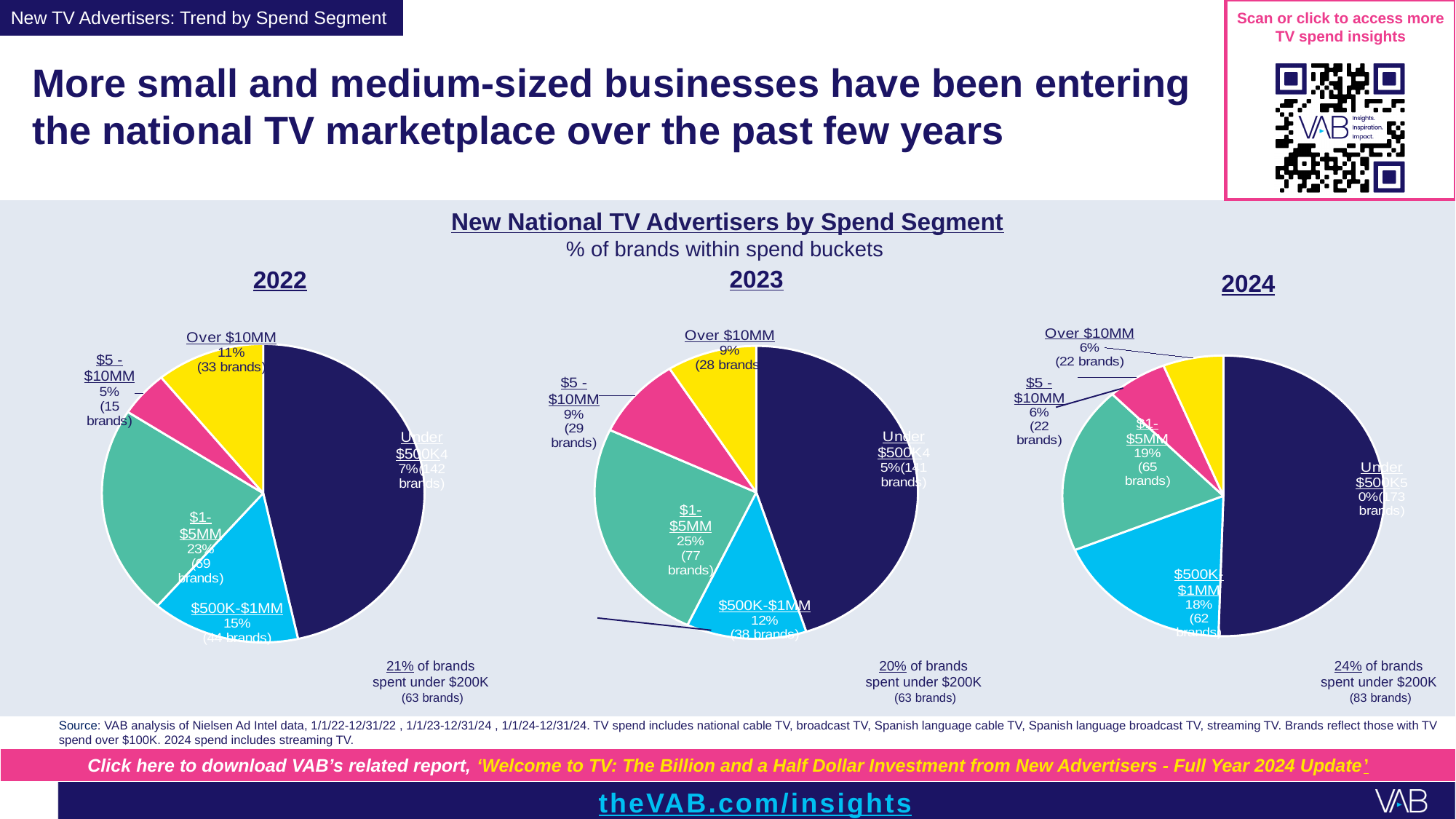
What kind of charts are shown on the slide? Pie charts How many pie charts are shown on the slide? 3 In the 2023 pie chart, what percentage of brands is in the $1-$5MM segment? 25% In the 2022 pie chart, what percentage of brands is in the Over $10MM segment? 11% In the 2024 pie chart, which spend segment has the largest share? Under $500K Across the 2022, 2023 and 2024 pie charts, does the share of the Over $10MM segment rise or fall? Fall In the 2023 pie chart, what is the difference in percentage points between the $1-$5MM segment and the $500K-$1MM segment? 13 percentage points In the 2022 pie chart, which is larger: the Over $10MM segment or the $500K-$1MM segment? $500K-$1MM In the 2023 pie chart, how many brands are in the Over $10MM segment? 28 brands In the 2022 pie chart, which spend segment has the smallest share? $5 - $10MM In the 2024 pie chart, what percentage of brands is in the $500K-$1MM segment? 18% How many spend segments does each pie chart contain? 5